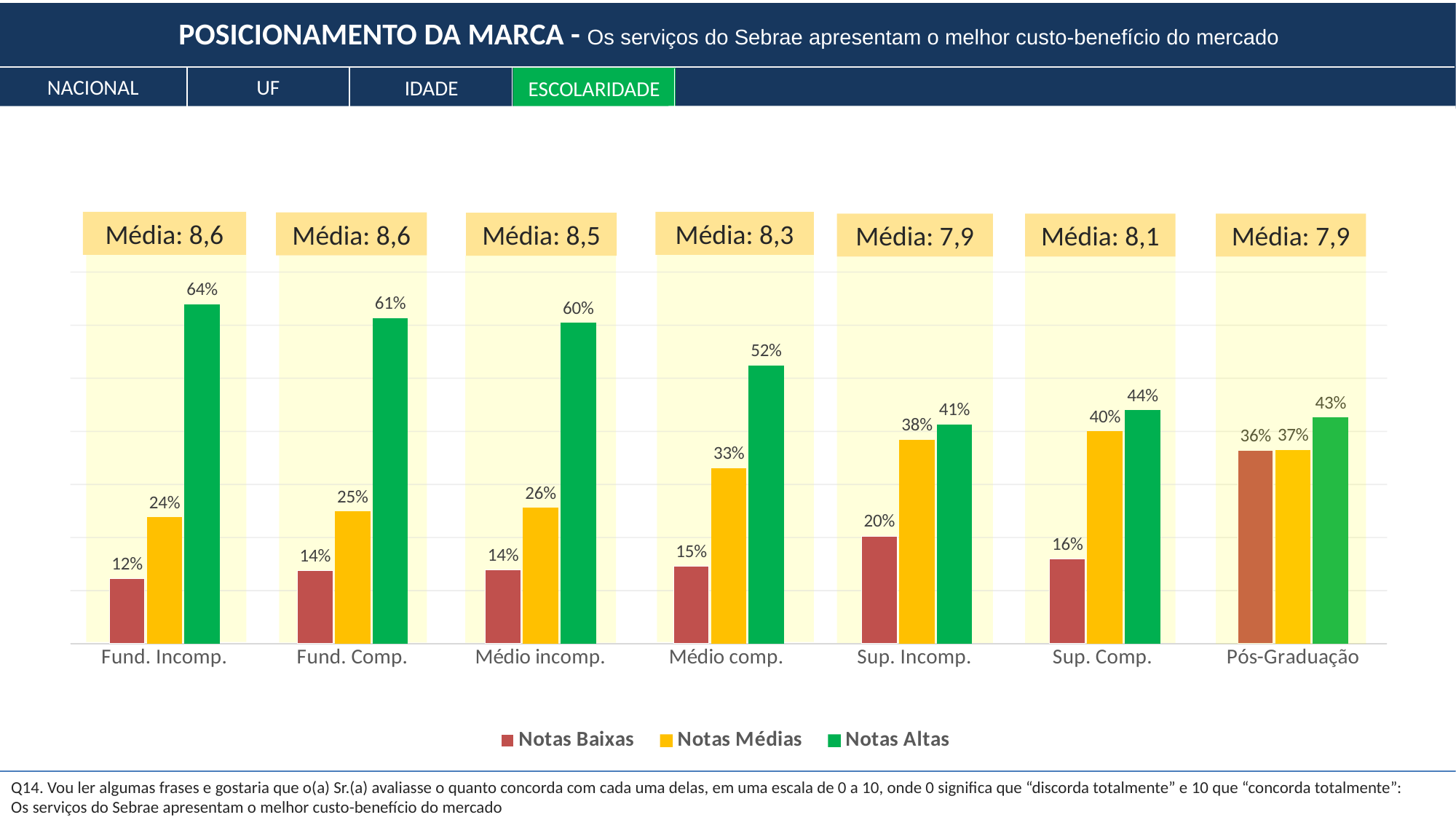
Which category has the lowest Notas Baixas value? Fund. Incomp. Do the Notas Baixas values generally rise or fall from Fund. Incomp. to Pós-Graduação? Rise How many education categories are shown on the x axis? 7 What is the value of Notas Altas for Fund. Incomp.? 64% What is the difference between Notas Altas and Notas Baixas for Médio comp.? 37% Which category has the highest Notas Altas value? Fund. Incomp. What kind of chart is shown on the slide? Bar chart What is the value of Notas Médias for Pós-Graduação? 37% What is the Média shown above the Médio comp. category? 8,3 What is the value of Notas Baixas for Sup. Incomp.? 20% How many series does the legend list? 3 Which is larger for Sup. Comp.: Notas Médias or Notas Altas? Notas Altas